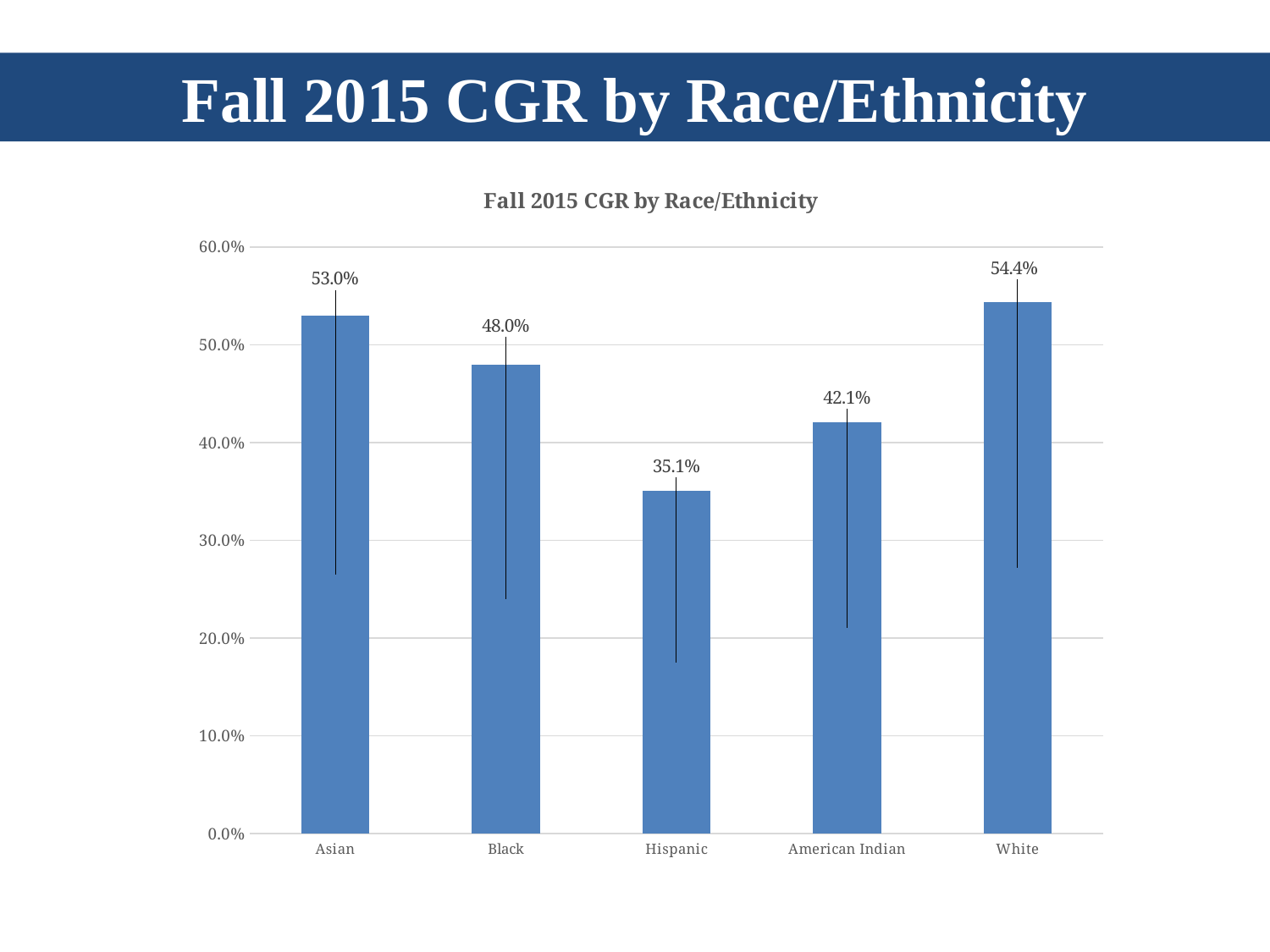
Which race/ethnicity category has the lowest CGR? Hispanic What kind of chart is shown on the slide? Bar chart Is the value for Hispanic greater or less than 40.0%? less What is the title of the chart? Fall 2015 CGR by Race/Ethnicity What is the difference between the CGR for White students and the CGR for Hispanic students? 19.3% What is the Fall 2015 CGR for Hispanic students? 35.1% What is the Fall 2015 CGR for Asian students? 53.0% Which race/ethnicity category has the highest CGR? White How many race/ethnicity categories are shown on the chart? 5 Which has a higher CGR, Black or American Indian? Black What is the Fall 2015 CGR for American Indian students? 42.1% What is the difference between the CGR for Asian students and the CGR for Black students? 5.0%